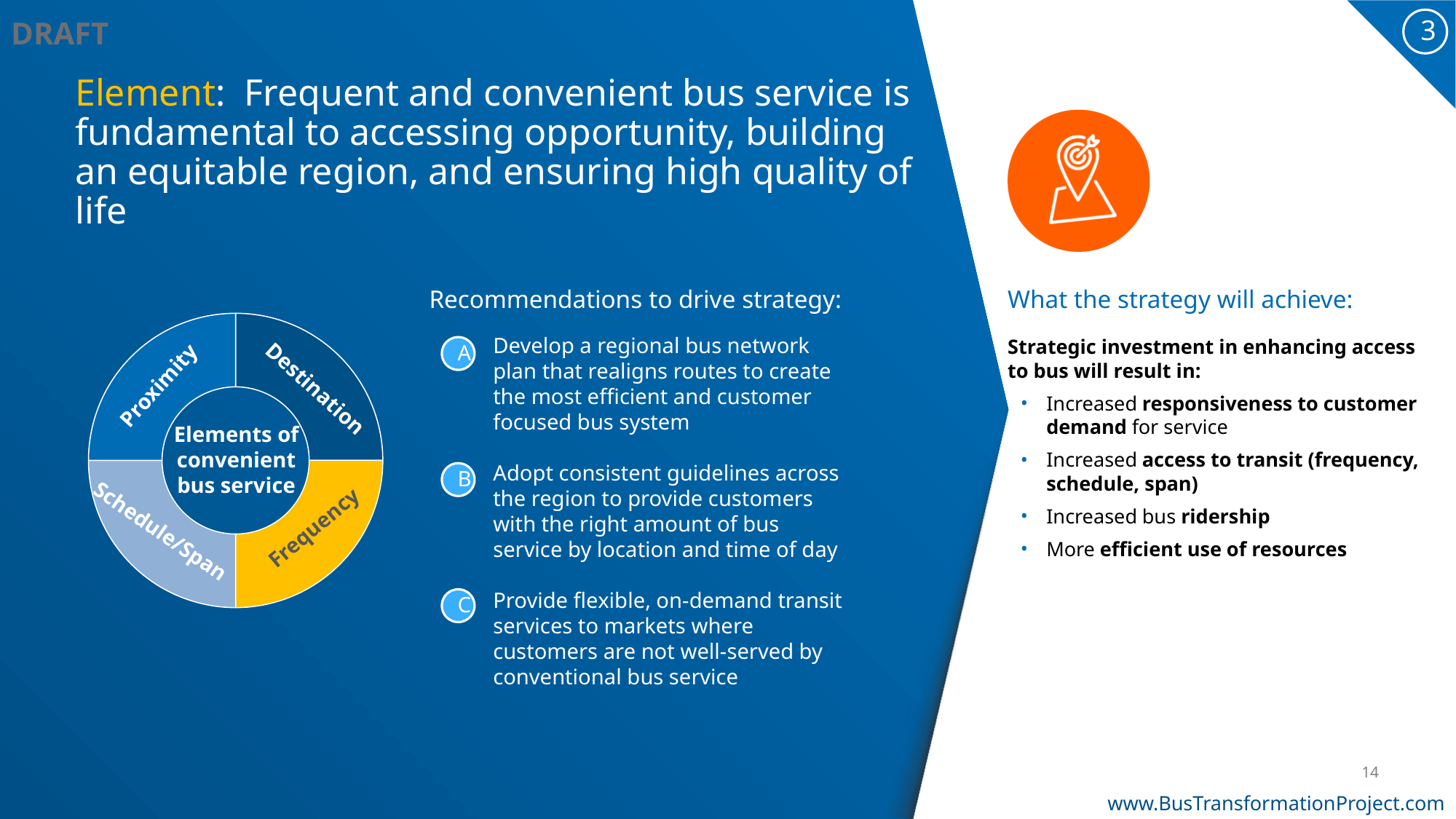
What text appears in the centre of the doughnut chart? Elements of convenient bus service Which segment of the doughnut chart is labelled in the top-right quarter? Destination How many segments does the doughnut chart on the left of the slide have? 4 Which segment of the doughnut chart is coloured yellow? Frequency What kind of chart is shown on the left of the slide? Doughnut chart Which segment of the doughnut chart is labelled in the bottom-left quarter? Schedule/Span